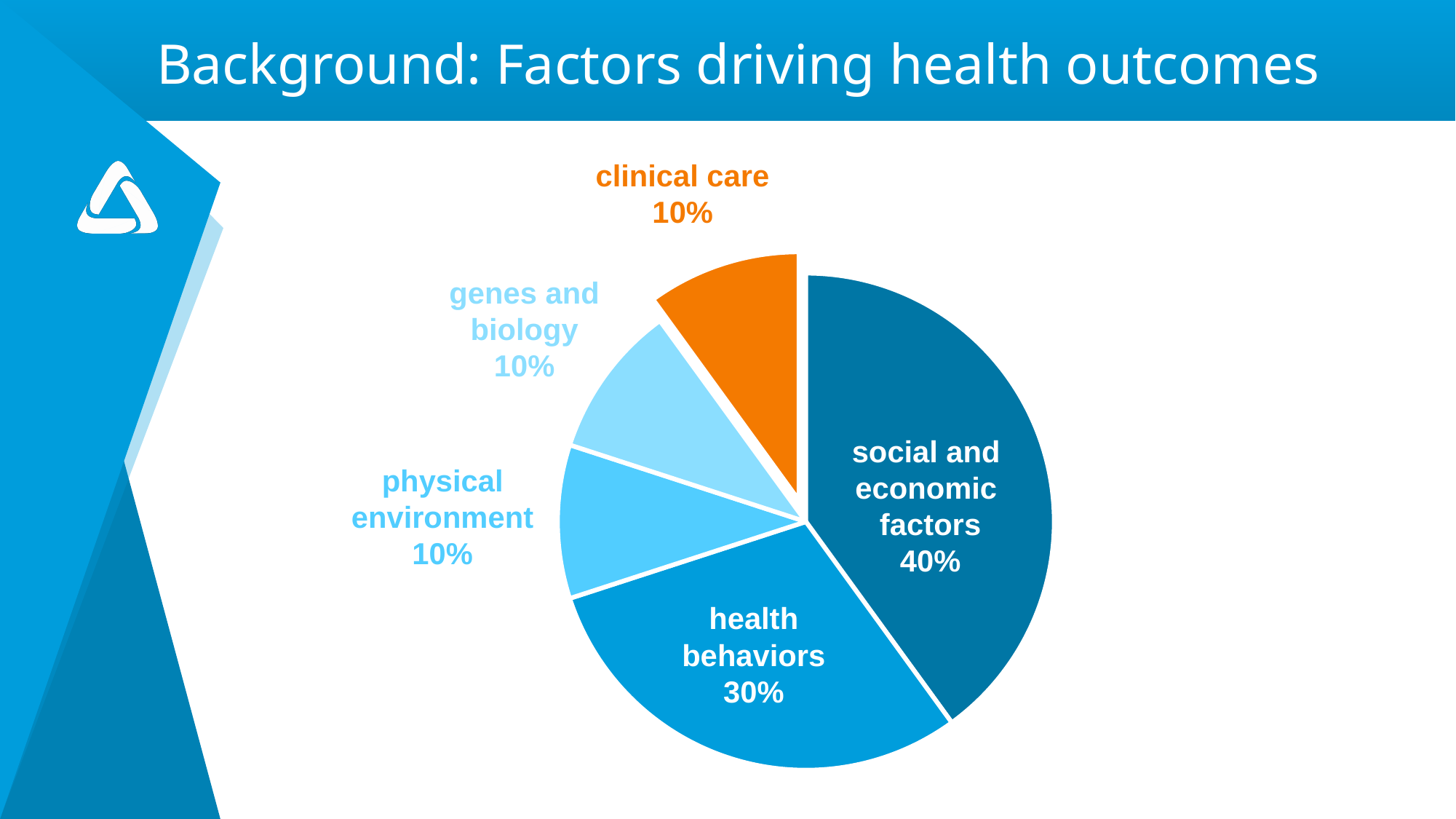
Which slice of the pie is the largest? social and economic factors What is the combined share of clinical care, genes and biology, and physical environment? 30% What share of the pie is clinical care? 10% What kind of chart is shown on the slide? pie chart What share of the pie is social and economic factors? 40% What share of the pie is physical environment? 10% What share of the pie is health behaviors? 30% Which is larger, the health behaviors slice or the genes and biology slice? health behaviors What is the title of the slide containing the pie chart? Background: Factors driving health outcomes Which slice of the pie is coloured orange? clinical care What is the difference between the social and economic factors share and the health behaviors share? 10% How many slices does the pie chart have? 5